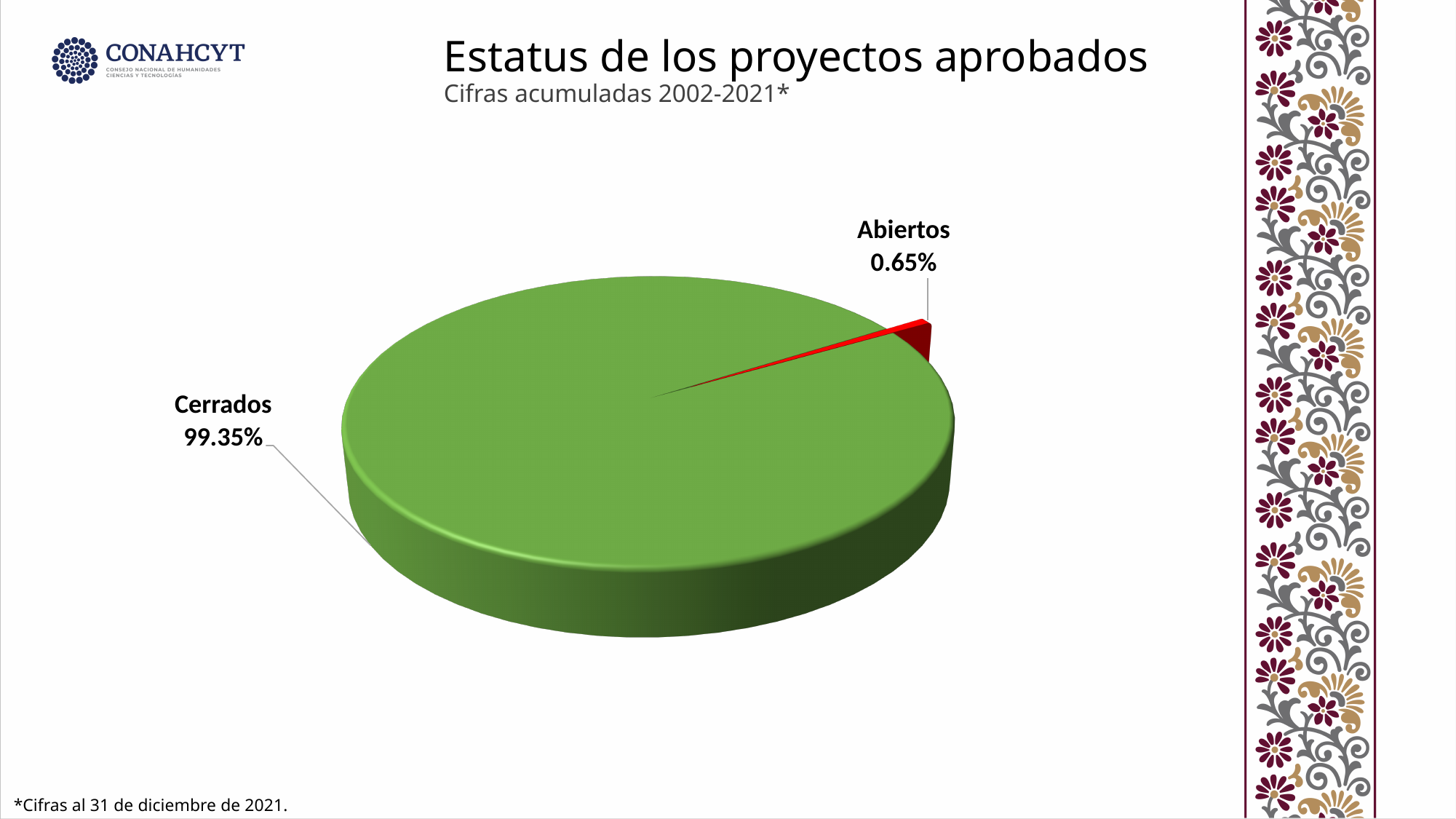
What kind of chart is shown on the slide? Pie chart What percentage of approved projects are Abiertos? 0.65% What percentage of approved projects are Cerrados? 99.35% What period do the accumulated figures cover according to the subtitle? 2002-2021 How many categories does the pie chart show? 2 What colour is the Abiertos slice? Red What is the title of the chart? Estatus de los proyectos aprobados Which is larger, the share for Cerrados or the share for Abiertos? Cerrados Which category has the smallest share of the pie? Abiertos Which category has the largest share of the pie? Cerrados What is the difference in percentage points between Cerrados and Abiertos? 98.70